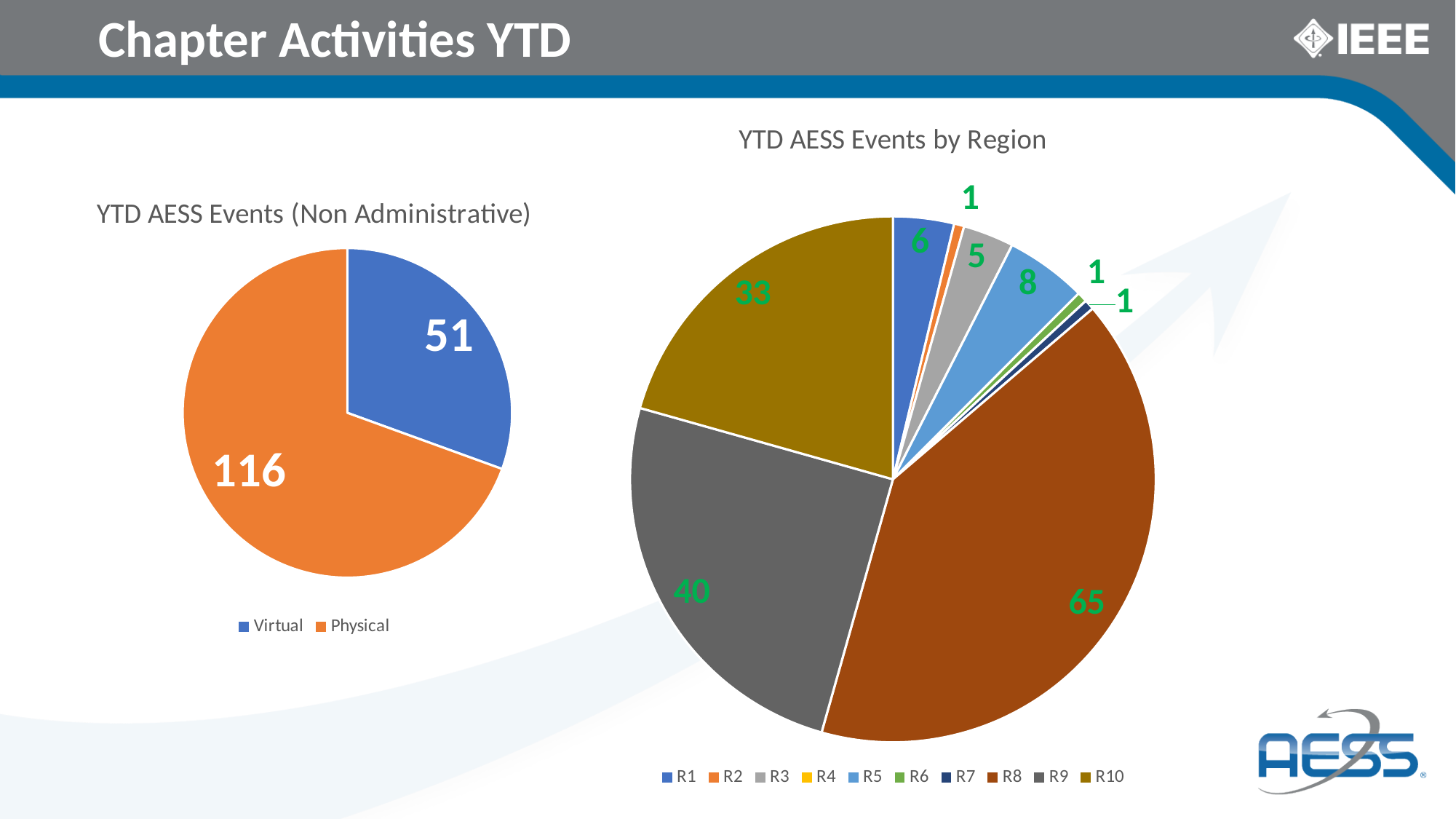
In the 'YTD AESS Events by Region' chart, what is the difference between R8 and R9? 25 In the 'YTD AESS Events (Non Administrative)' chart, what is the value for Virtual? 51 How many regions does the legend of the 'YTD AESS Events by Region' chart list? 10 In the 'YTD AESS Events by Region' chart, what is the value for R5? 8 In the 'YTD AESS Events by Region' chart, what is the value for R8? 65 What kind of chart is 'YTD AESS Events by Region'? Pie chart In the 'YTD AESS Events by Region' chart, which region has the highest number of events? R8 In the 'YTD AESS Events by Region' chart, what is the value for R10? 33 In the 'YTD AESS Events (Non Administrative)' chart, what is the value for Physical? 116 In the 'YTD AESS Events by Region' chart, what is the value for R9? 40 In the 'YTD AESS Events (Non Administrative)' chart, what is the difference between Physical and Virtual events? 65 In the 'YTD AESS Events (Non Administrative)' chart, which category is larger, Virtual or Physical? Physical